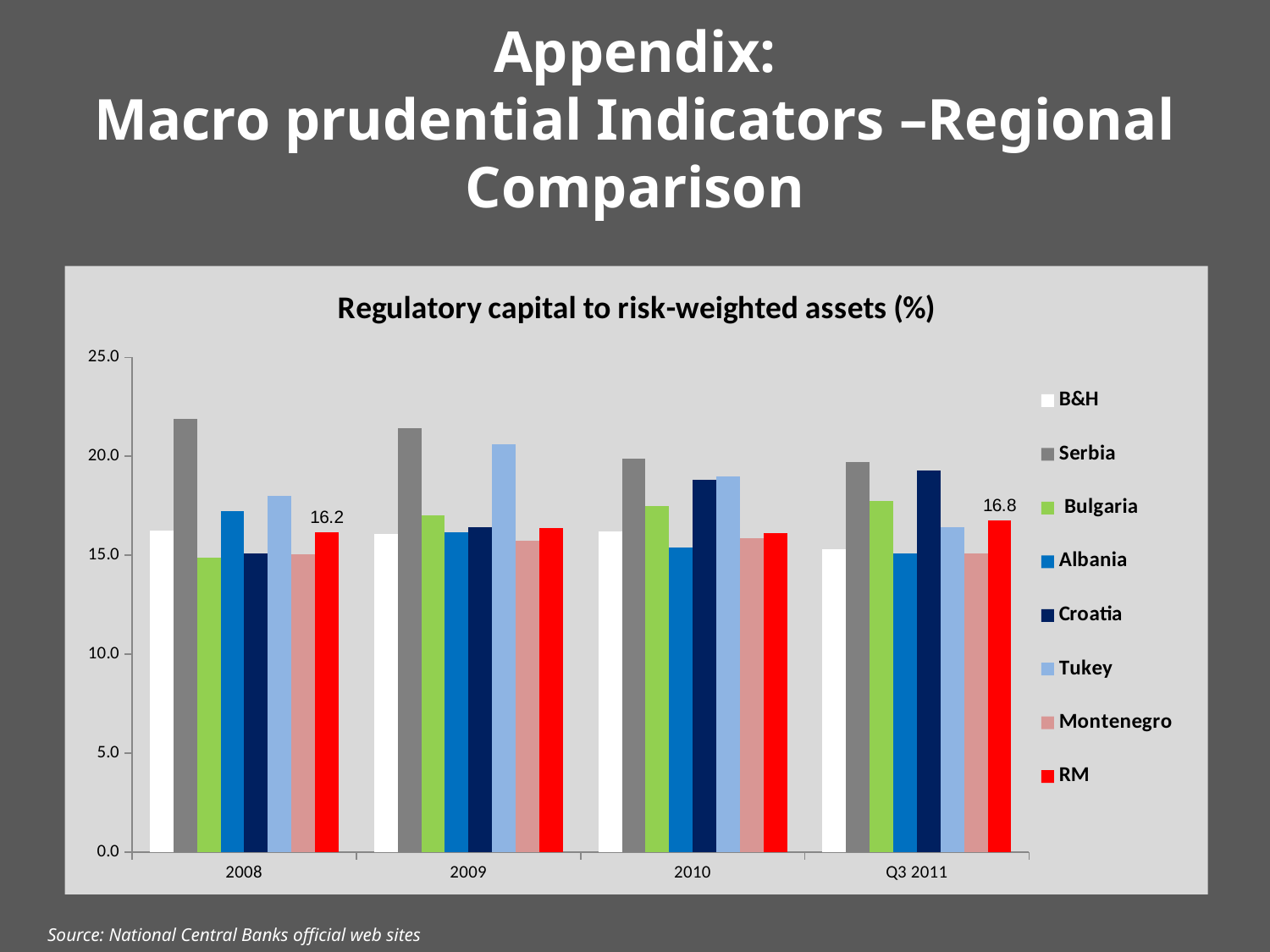
How many series does the legend list? 8 By how much did the value for RM change from 2008 to Q3 2011? 0.6 What is the value for RM in 2008? 16.2 Which country has the highest value in 2008? Serbia What is the value for RM in Q3 2011? 16.8 How many time periods are shown on the x axis? 4 Is the value for Serbia in 2008 greater or less than 20.0? greater What kind of chart is shown on the slide? bar chart Do the values for Croatia rise or fall from 2008 to Q3 2011? rise Which is larger in 2010, the value for Croatia or the value for Albania? Croatia Is the value for Tukey in Q3 2011 greater or less than 20.0? less Which country has the highest value in 2010? Serbia